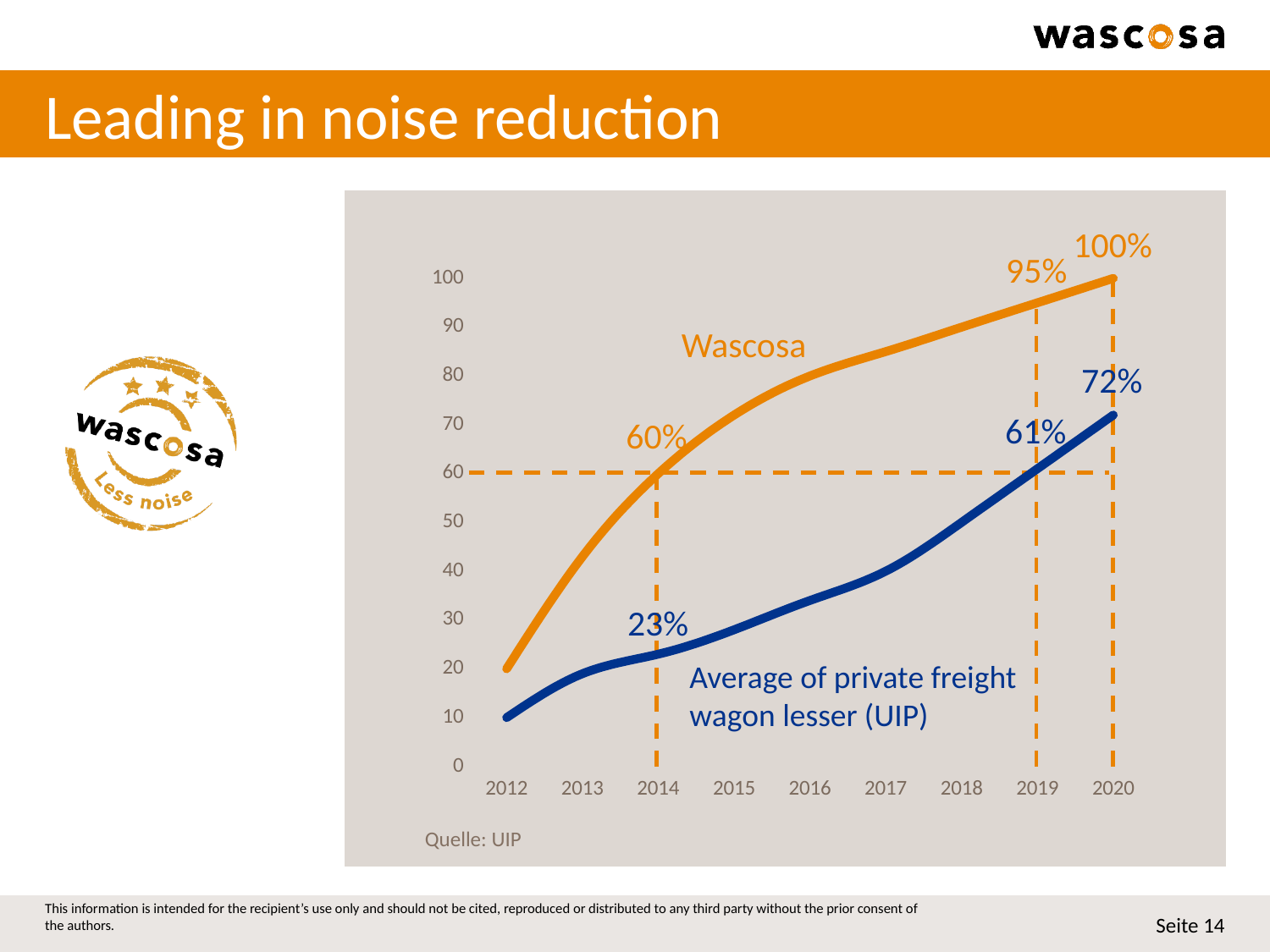
What is the value for the average of private freight wagon lesser (UIP) in 2019? 61% How many years are shown on the x axis? 9 Is the value for Wascosa in 2016 greater or less than 70? greater What is the value for Wascosa in 2014? 60% What is the value for Wascosa in 2019? 95% What is the value for the average of private freight wagon lesser (UIP) in 2014? 23% What is the difference between the Wascosa value and the UIP average value in 2014? 37% What type of chart is shown on the slide? line chart What is the difference between the Wascosa value and the UIP average value in 2020? 28% Do the values for Wascosa rise or fall from 2012 to 2020? rise Which series is higher in 2019, Wascosa or the average of private freight wagon lesser (UIP)? Wascosa What is the value for Wascosa in 2020? 100%